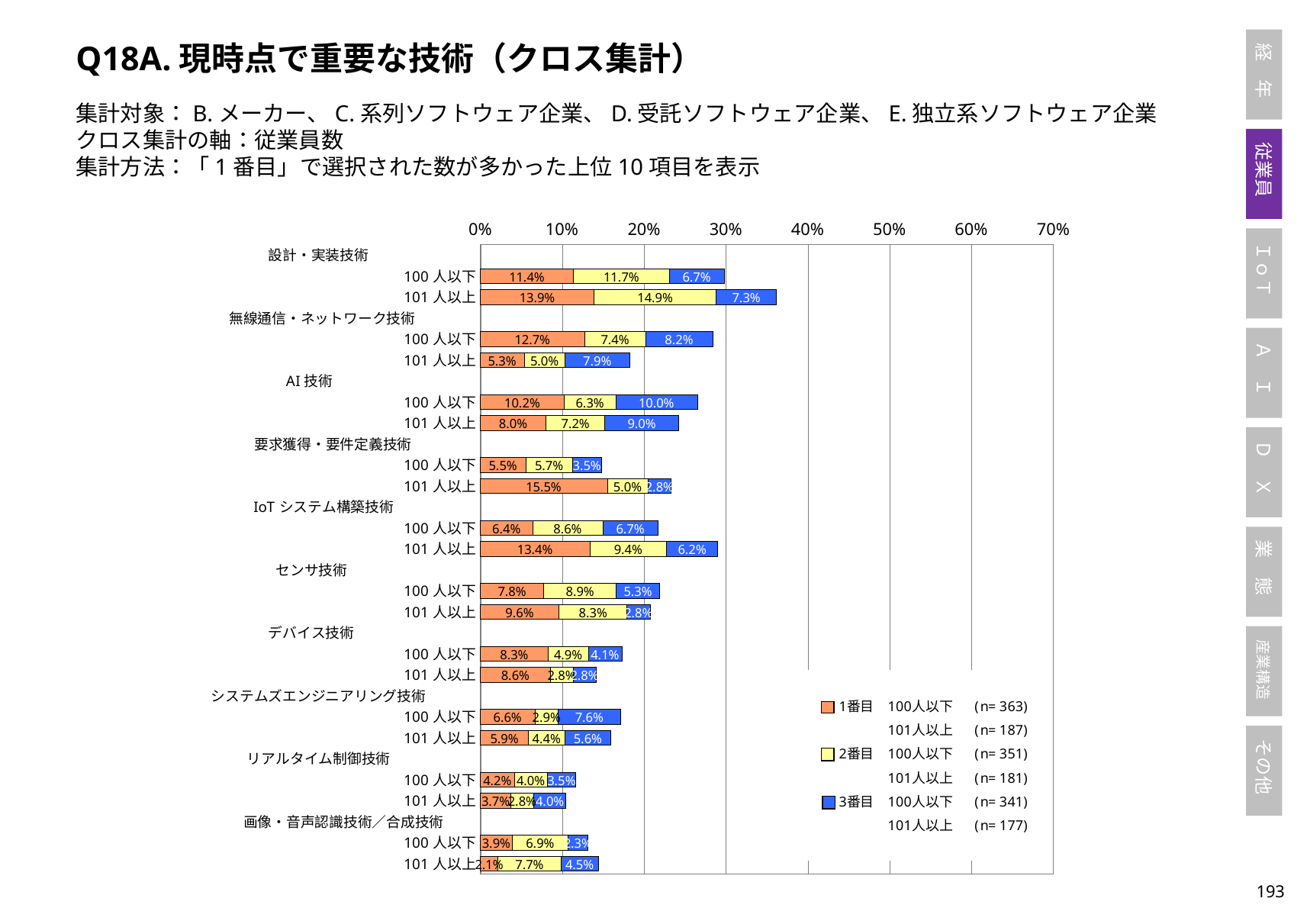
What kind of chart is shown on the slide? Stacked horizontal bar chart Which bar has the highest 1番目 value in the chart? 要求獲得・要件定義技術, 101人以上 (15.5%) What is the total of the stacked bar for 設計・実装技術, 101人以上? 36.1% How many series does the legend list? 3 What is the total of the stacked bar for 設計・実装技術, 100人以下? 29.8% What is the difference between the 1番目 values for 要求獲得・要件定義技術 between 101人以上 and 100人以下? 10.0 percentage points For 無線通信・ネットワーク技術, which group has the larger 1番目 value, 100人以下 or 101人以上? 100人以下 Is the total stacked bar for 設計・実装技術, 101人以上 greater or less than 30%? greater What is the 2番目 value for センサ技術 among 101人以上 respondents? 8.3% How many technology categories are shown in the chart? 10 What is the 3番目 value for AI技術 among 100人以下 respondents? 10.0% What is the 1番目 value for 設計・実装技術 among 101人以上 respondents? 13.9%